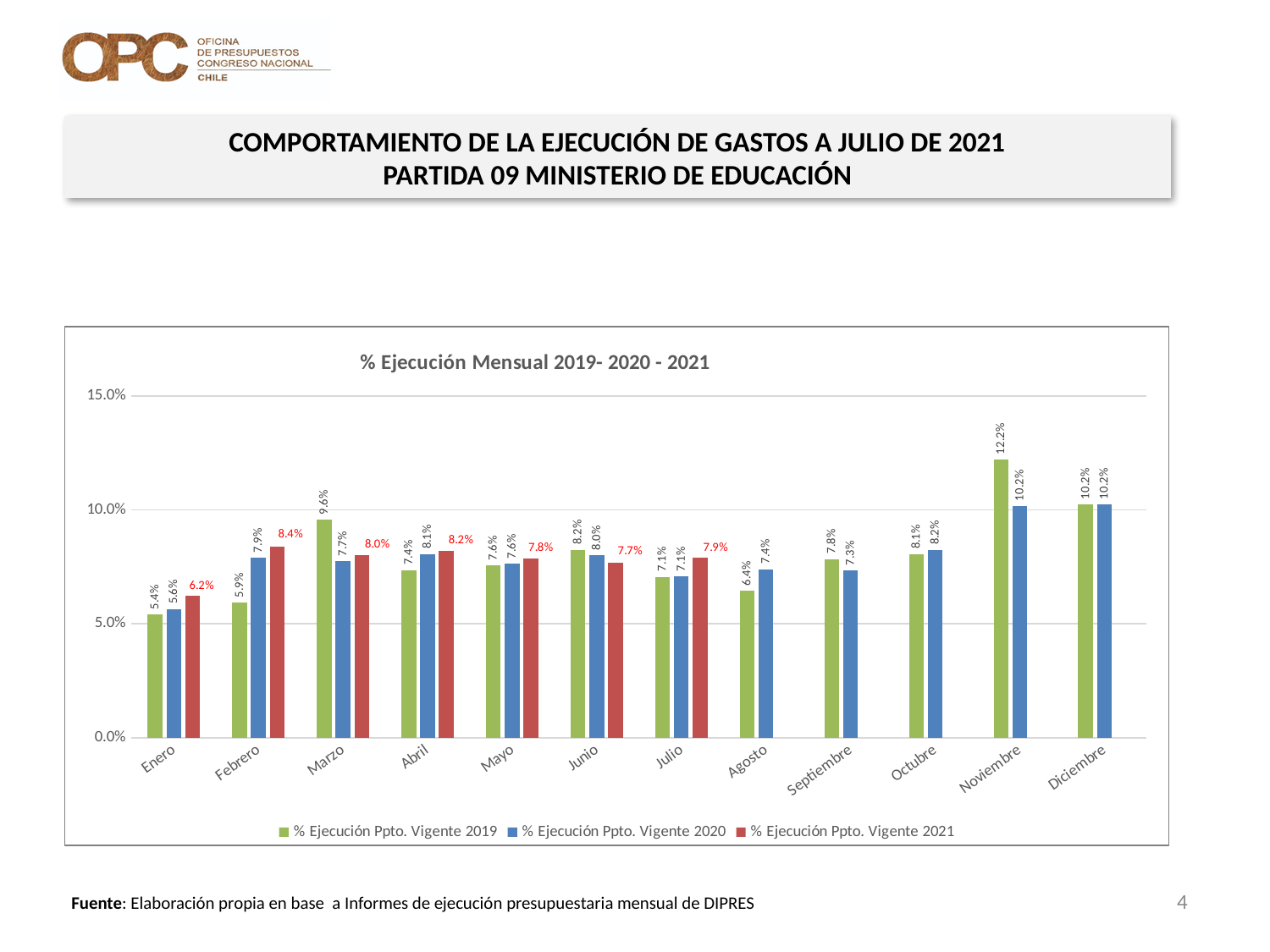
Which is larger in Marzo: the 2019 value or the 2020 value? 2019 value (9.6%) Which month has the highest value for % Ejecución Ppto. Vigente 2019? Noviembre What is the value for % Ejecución Ppto. Vigente 2021 in Marzo? 8.0% How many months are shown on the x axis? 12 What is the value for % Ejecución Ppto. Vigente 2019 in Noviembre? 12.2% What is the difference between the 2019 and 2020 values in Noviembre? 2.0% What is the value for % Ejecución Ppto. Vigente 2020 in Agosto? 7.4% Is the value for % Ejecución Ppto. Vigente 2019 in Diciembre greater or less than 10.0%? greater How many series does the legend list? 3 What kind of chart is shown? Bar chart Which month has the lowest value for % Ejecución Ppto. Vigente 2021? Enero What is the title of the chart? % Ejecución Mensual 2019- 2020 - 2021